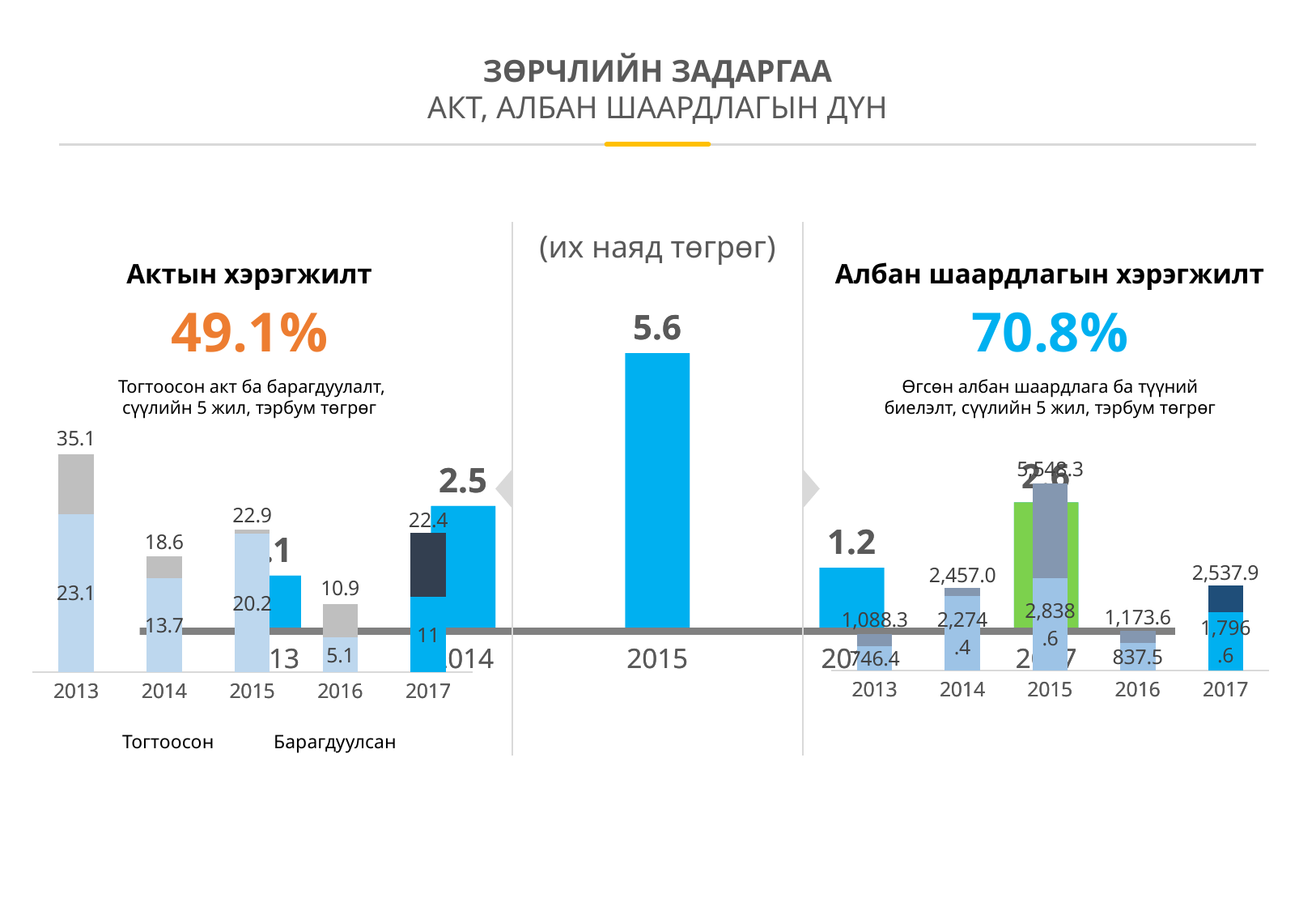
In the Актын хэрэгжилт chart on the left, what is the total value shown above the 2013 bar? 35.1 In the Албан шаардлагын хэрэгжилт chart on the right, what is the total value shown above the 2014 bar? 2,457.0 In the Актын хэрэгжилт chart on the left, what is the value of the lower (Тогтоосон) segment of the 2013 bar? 23.1 In the Актын хэрэгжилт chart on the left, which year has the lowest total? 2016 In the Актын хэрэгжилт chart on the left, what is the difference between the 2013 total (35.1) and the 2016 total (10.9)? 24.2 In the Актын хэрэгжилт chart on the left, how many years are shown on the x axis? 5 In the Албан шаардлагын хэрэгжилт chart on the right, which is larger: the 2017 total or the 2016 total? 2017 In the middle chart labelled (их наяд төгрөг), what value is shown above the 2015 bar? 5.6 In the Актын хэрэгжилт chart on the left, which year has the highest total? 2013 In the Албан шаардлагын хэрэгжилт chart on the right, what is the value of the lower segment of the 2016 bar? 837.5 In the Актын хэрэгжилт chart on the left, how many series does the legend list? 2 What kind of chart is the Албан шаардлагын хэрэгжилт chart on the right? bar chart